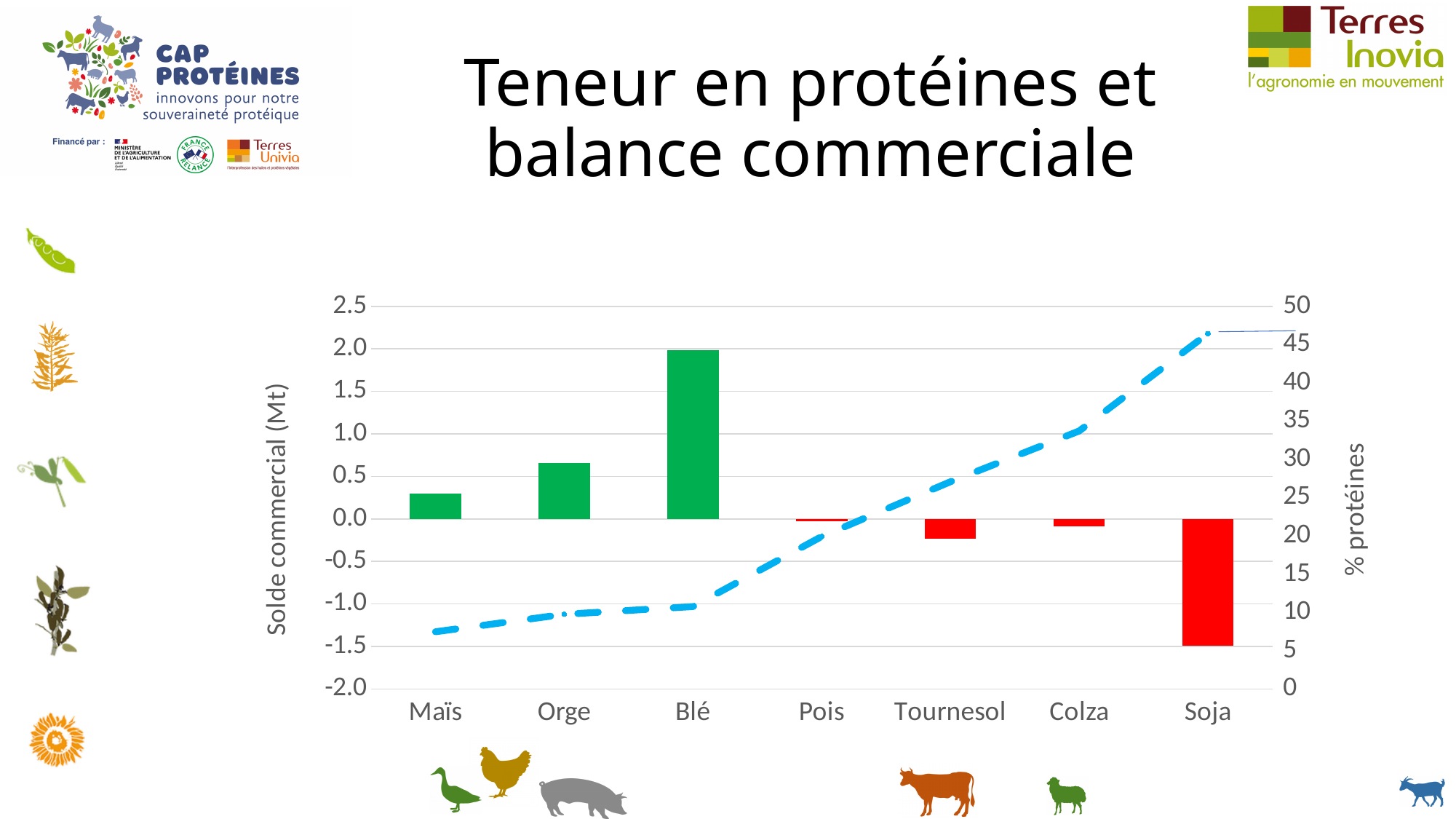
Does the dashed line for % protéines rise or fall from Maïs to Soja? Rises How many categories are shown on the x axis of the chart? 7 Is the solde commercial bar for Maïs greater or less than 0.5? less Which has the larger solde commercial bar, Blé or Orge? Blé Is the solde commercial bar for Blé greater or less than 1.5? greater What is the title of the right vertical axis? % protéines What kind of chart is shown on the slide? Bar chart with a line Which category has the lowest bar for solde commercial? Soja What is the title of the left vertical axis? Solde commercial (Mt) Is the solde commercial bar for Orge greater or less than 0.5? greater Which category has the highest bar for solde commercial? Blé